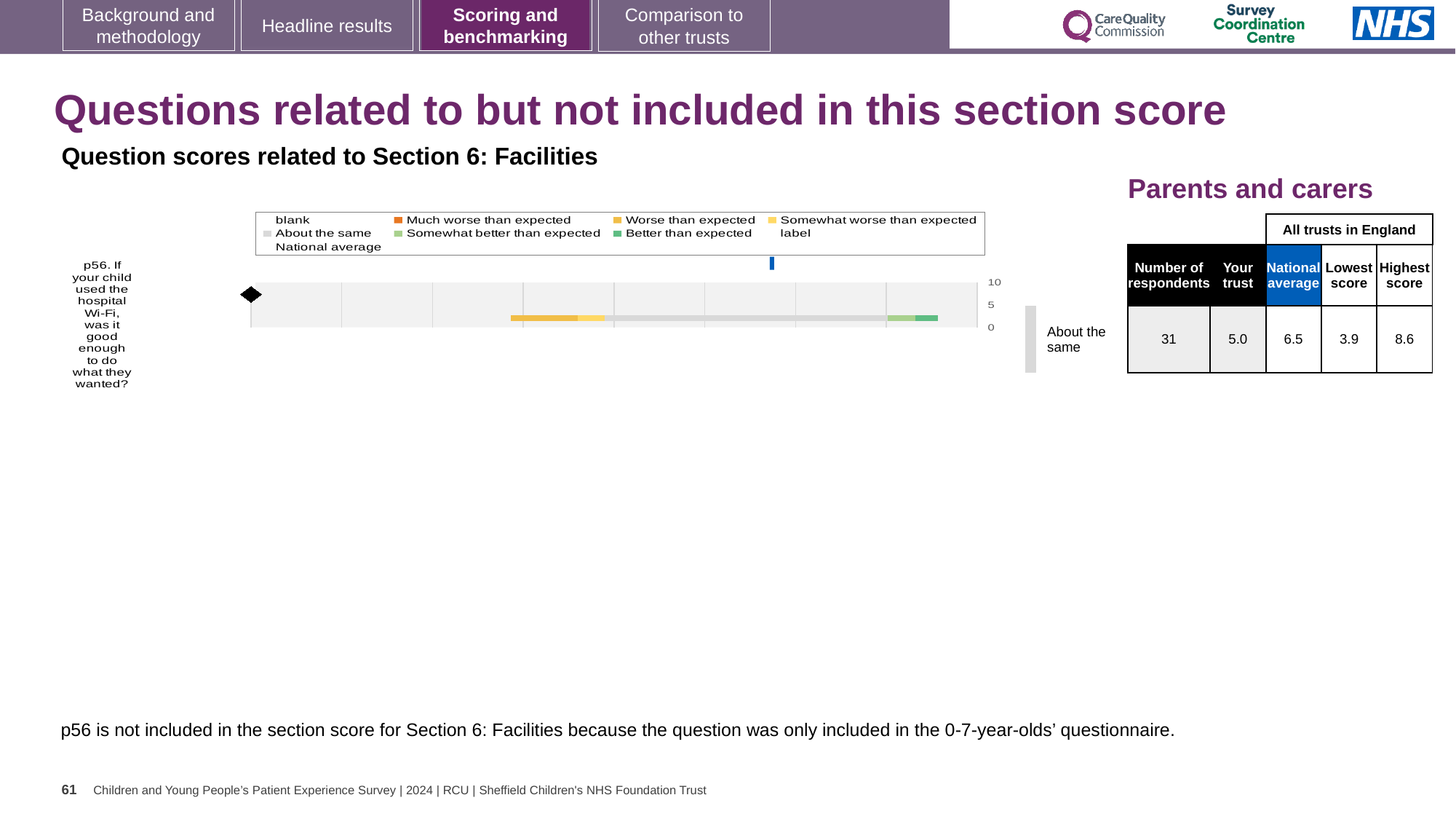
What is the lowest score across all trusts in England for p56? 3.9 What is the national average score for p56 shown in the table beside the chart? 6.5 What kind of chart is shown for question p56? bar chart How many respondents answered p56 for this trust? 31 What is the highest score across all trusts in England for p56? 8.6 Which survey question is plotted in the chart? p56. If your child used the hospital Wi-Fi, was it good enough to do what they wanted? What benchmarking category label is shown next to the p56 bar? About the same What is the 'Your trust' score for p56 shown in the table beside the chart? 5.0 Which is larger for p56: the 'Your trust' score or the national average? National average How many entries does the chart legend list? 9 What is the difference between the highest score and the lowest score for p56? 4.7 How many survey questions are plotted in the chart? 1